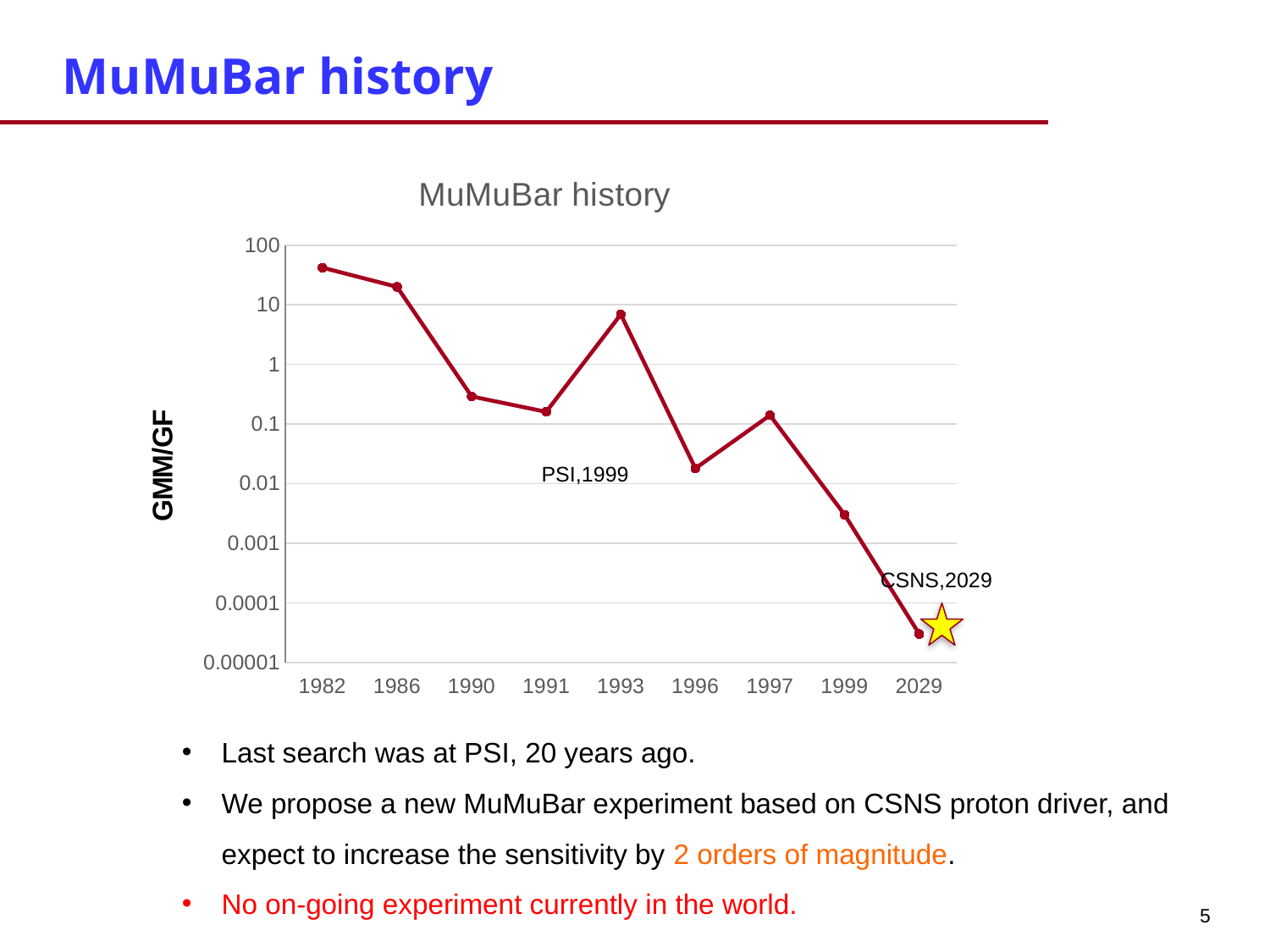
Is the value for 2029 greater or less than 0.0001? less Which year has the highest GMM/GF value? 1982 Overall, do the GMM/GF values rise or fall from 1982 to 2029? fall Is the value for 1999 greater or less than 0.01? less Is the value for 1982 greater or less than 10? greater Which year has the lowest GMM/GF value? 2029 Which has the larger GMM/GF value, 1991 or 1993? 1993 How many data points are plotted on the MuMuBar history chart? 9 What kind of chart is shown on the slide? line chart What is the label on the y axis of the chart? GMM/GF